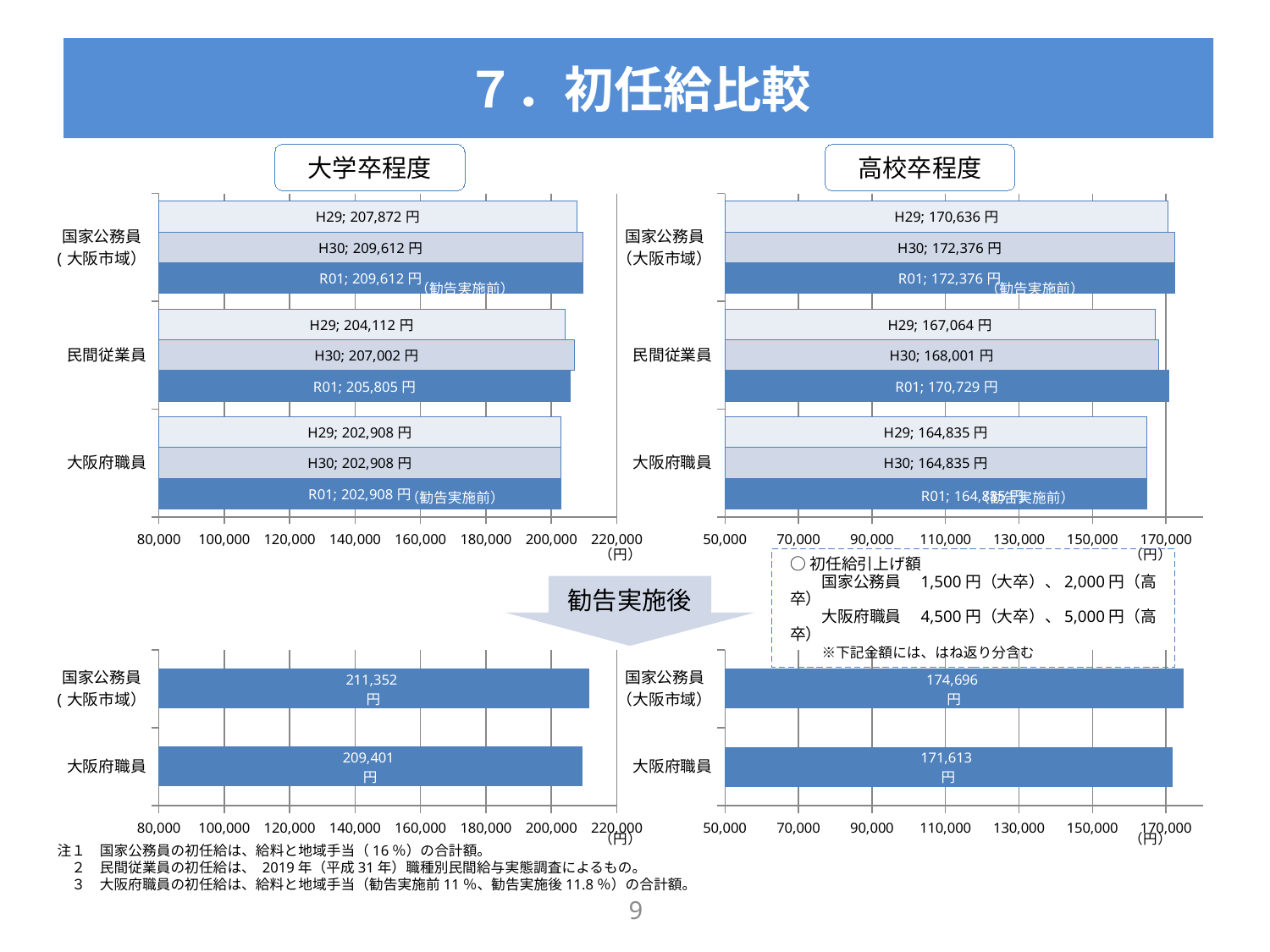
In the top-right chart (高校卒程度), what is the H30 value for 民間従業員? 168,001 円 In the top-left chart (大学卒程度), what is the R01 value for 民間従業員? 205,805 円 What type of chart is the top-left chart (大学卒程度)? Bar chart In the bottom-right chart (勧告実施後, 高校卒程度), what is the difference between 国家公務員(大阪市域) and 大阪府職員? 3,083 円 In the top-left chart (大学卒程度), which category has the lowest H29 value? 大阪府職員 In the top-left chart (大学卒程度), what is the H29 value for 国家公務員(大阪市域)? 207,872 円 In the bottom-left chart (勧告実施後, 大学卒程度), what is the difference between 国家公務員(大阪市域) and 大阪府職員? 1,951 円 In the bottom-left chart (勧告実施後, 大学卒程度), what is the value for 国家公務員(大阪市域)? 211,352 円 In the bottom-right chart (勧告実施後, 高校卒程度), what is the value for 大阪府職員? 171,613 円 In the top-right chart (高校卒程度), which is larger for R01: 国家公務員(大阪市域) or 民間従業員? 国家公務員(大阪市域) In the top-right chart (高校卒程度), what is the R01 value for 国家公務員(大阪市域)? 172,376 円 In the top-left chart (大学卒程度), what is the difference between the H30 and H29 values for 民間従業員? 2,890 円